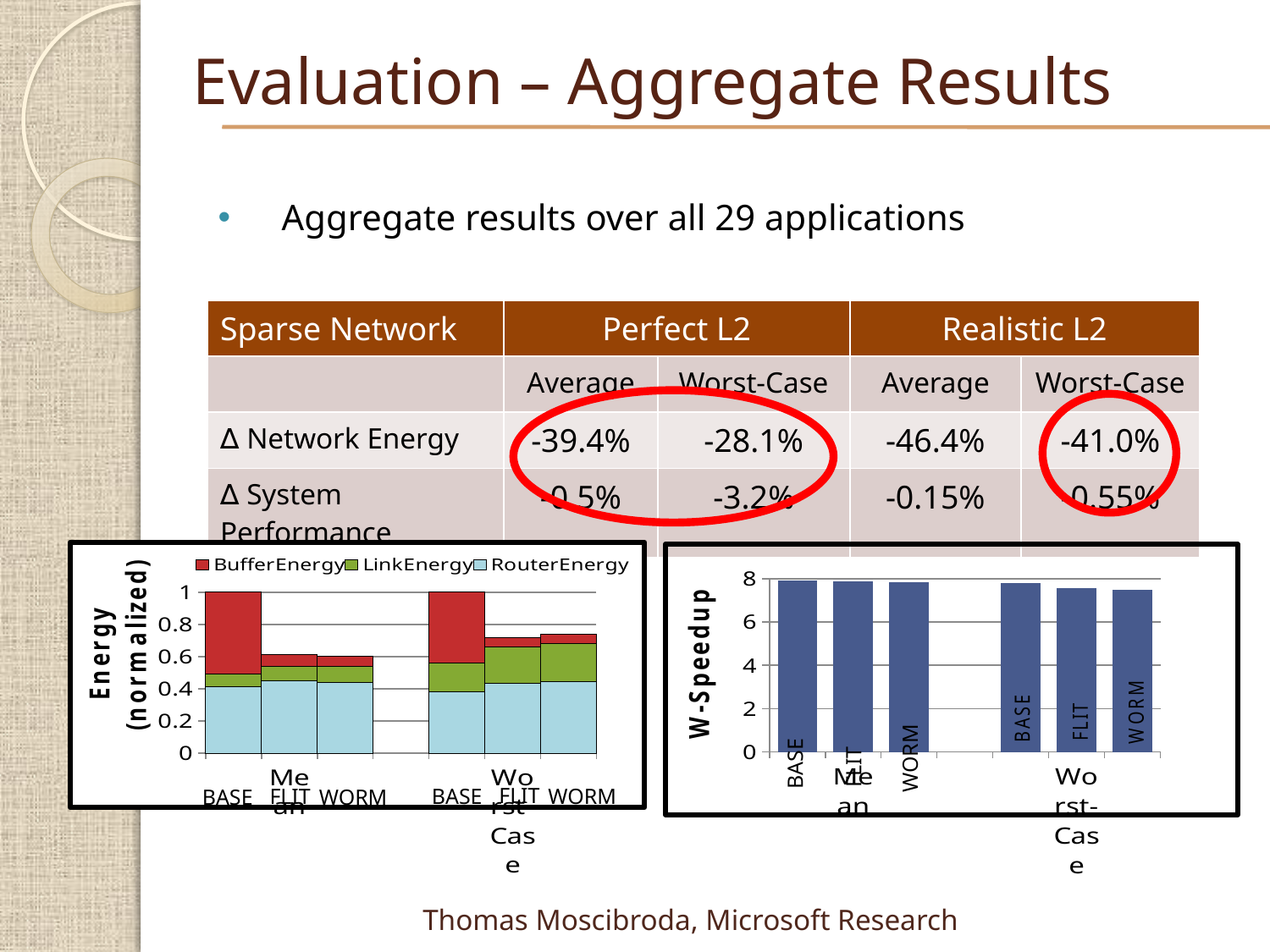
In the left chart (Energy normalized), which bar in the Mean group is the tallest? BASE In the left chart (Energy normalized), is the total for FLIT in the Mean group greater or less than 0.8? less In the left chart (Energy normalized), what is the total normalized energy of the BASE bar in the Mean group? 1 In the right chart (W-Speedup), is the value for BASE in the Mean group greater or less than 6? greater What kind of chart is the right chart (W-Speedup)? bar chart In the left chart (Energy normalized), which is larger in the Worst-Case group: the BASE bar or the WORM bar? BASE In the left chart (Energy normalized), is the total for WORM in the Worst-Case group greater or less than 0.6? greater How many stacked bars are plotted in the left chart (Energy normalized)? 6 How many bars are plotted in the right chart (W-Speedup)? 6 What are the legend entries of the left chart (Energy normalized)? BufferEnergy, LinkEnergy, RouterEnergy How many series does the legend of the left chart (Energy normalized) list? 3 What kind of chart is the left chart (Energy normalized)? bar chart